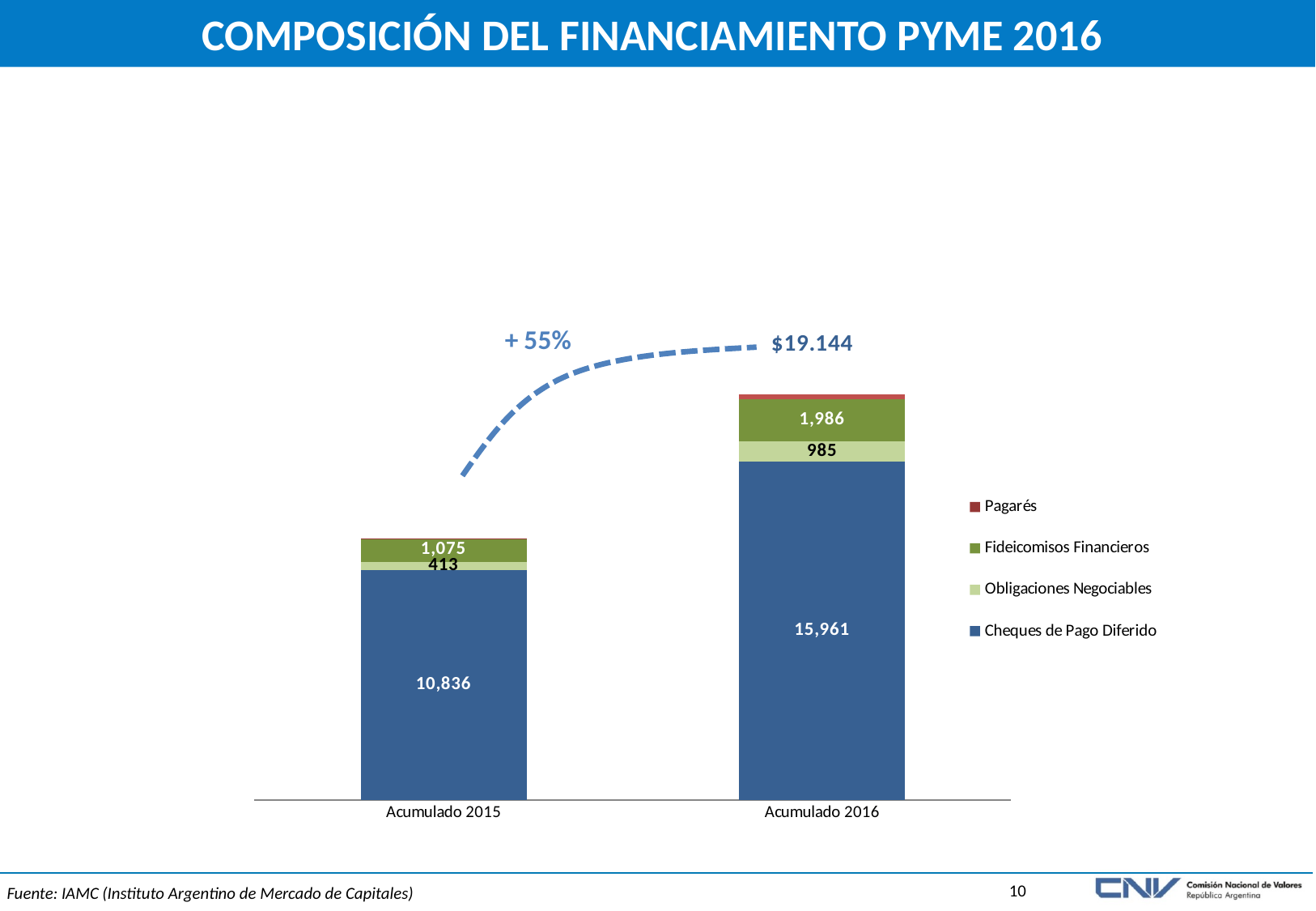
Which category has the larger value for Obligaciones Negociables, Acumulado 2015 or Acumulado 2016? Acumulado 2016 What type of chart is shown on the slide? stacked bar chart How many categories are shown on the x axis? 2 What is the difference in Fideicomisos Financieros between Acumulado 2016 and Acumulado 2015? 911 What is the value of Cheques de Pago Diferido for Acumulado 2016? 15,961 How many series does the legend list? 4 What is the difference in Cheques de Pago Diferido between Acumulado 2016 and Acumulado 2015? 5,125 What percentage growth is annotated between Acumulado 2015 and Acumulado 2016? + 55% What is the value of Cheques de Pago Diferido for Acumulado 2015? 10,836 Which series is the largest component of the Acumulado 2016 bar? Cheques de Pago Diferido What is the value of Obligaciones Negociables for Acumulado 2015? 413 What is the value of Fideicomisos Financieros for Acumulado 2016? 1,986